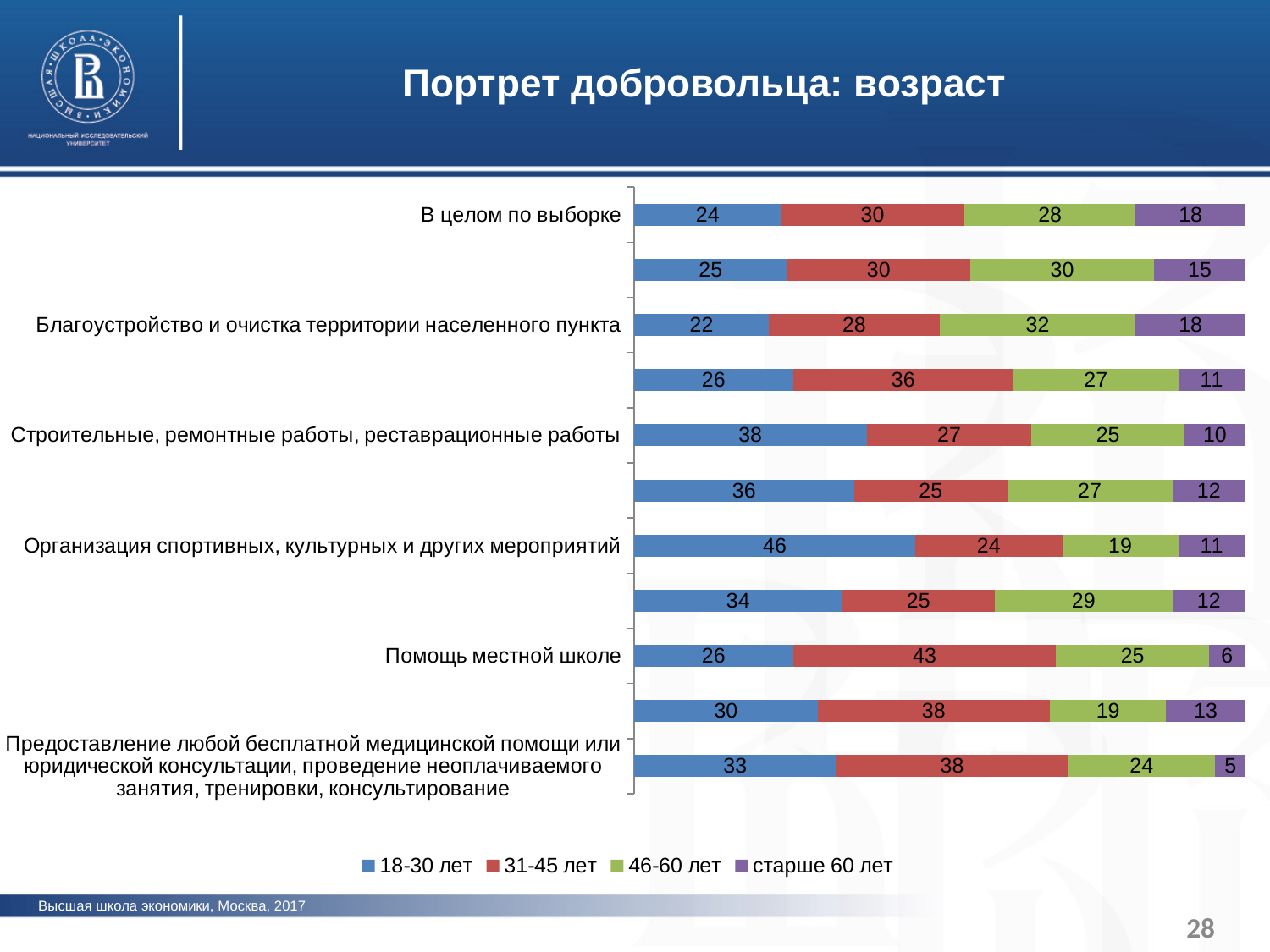
What is the value for the старше 60 лет series in the 'Предоставление любой бесплатной медицинской помощи или юридической консультации...' bar? 5 Which age group has the highest value in the 'Организация спортивных, культурных и других мероприятий' bar? 18-30 лет Which is larger: the 18-30 лет value for 'Организация спортивных, культурных и других мероприятий' or the 18-30 лет value for 'Помощь местной школе'? Организация спортивных, культурных и других мероприятий What kind of chart is shown on the slide? stacked bar chart What is the value for the 46-60 лет series in the 'Благоустройство и очистка территории населенного пункта' bar? 32 Which age group has the lowest value in the 'Строительные, ремонтные работы, реставрационные работы' bar? старше 60 лет How many bars are plotted in the chart? 11 What is the value for the 18-30 лет series in the 'В целом по выборке' bar? 24 What is the total of the 'В целом по выборке' stacked bar? 100 What is the value for the 31-45 лет series in the 'Помощь местной школе' bar? 43 How many series does the legend list? 4 What is the difference between the 18-30 лет value and the 31-45 лет value in the 'Строительные, ремонтные работы, реставрационные работы' bar? 11